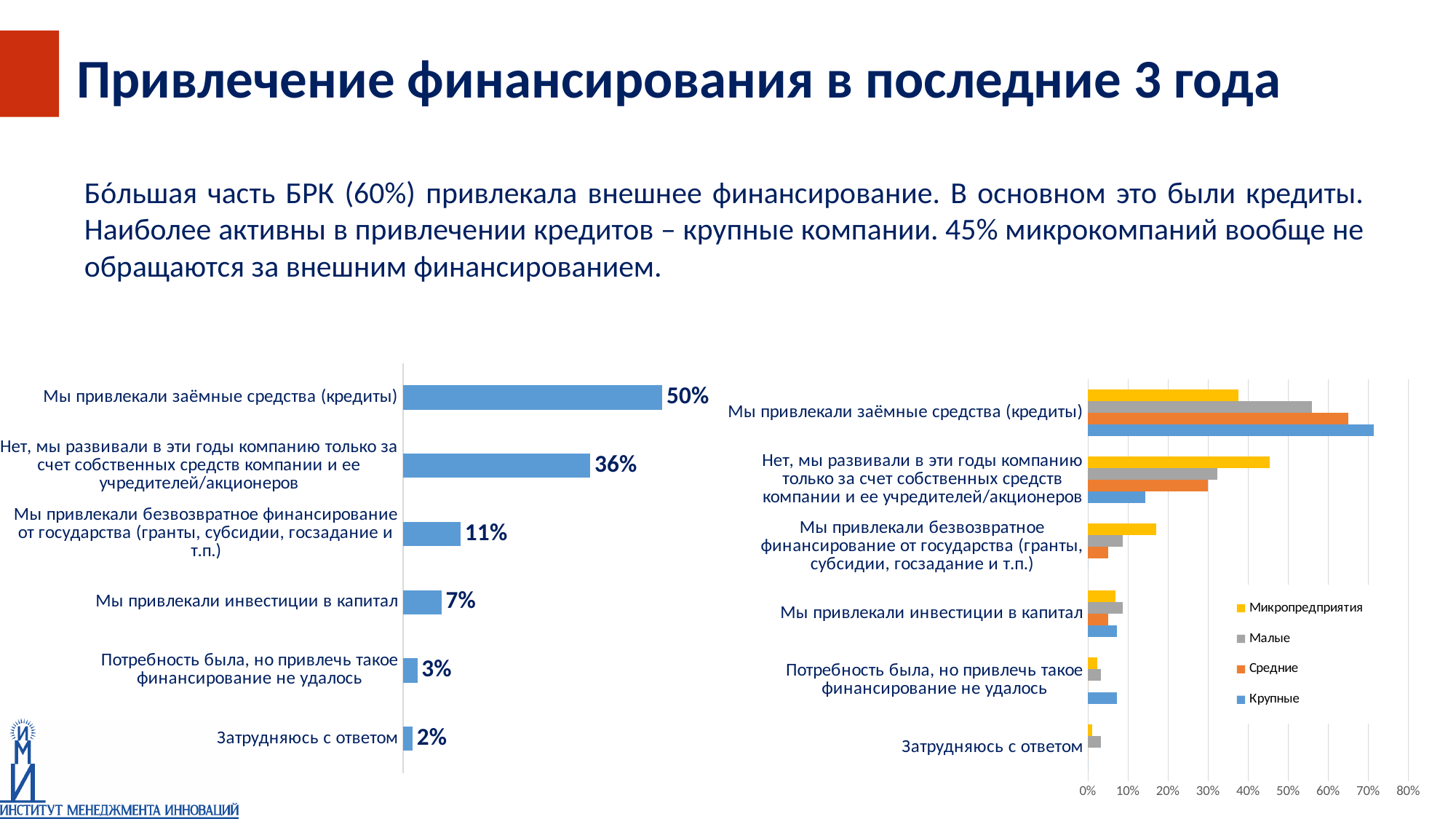
In the left chart, what is the difference between the value for «Мы привлекали заёмные средства (кредиты)» and the value for «Нет, мы развивали в эти годы компанию только за счет собственных средств компании и ее учредителей/акционеров»? 14% How many categories does the left chart show? 6 In the left chart, what is the value for «Затрудняюсь с ответом»? 2% How many series does the legend of the right chart list? 4 In the left chart, what is the value for «Мы привлекали заёмные средства (кредиты)»? 50% In the left chart, which category has the highest value? Мы привлекали заёмные средства (кредиты) In the left chart, what is the value for «Мы привлекали инвестиции в капитал»? 7% What kind of chart is the right chart? Bar chart In the right chart, which series is shown in blue according to the legend? Крупные In the right chart, is the value for «Крупные» in the category «Мы привлекали заёмные средства (кредиты)» greater or less than 60%? greater In the left chart, which is larger: the value for «Мы привлекали безвозвратное финансирование от государства» or the value for «Мы привлекали инвестиции в капитал»? Мы привлекали безвозвратное финансирование от государства In the left chart, which category has the lowest value? Затрудняюсь с ответом